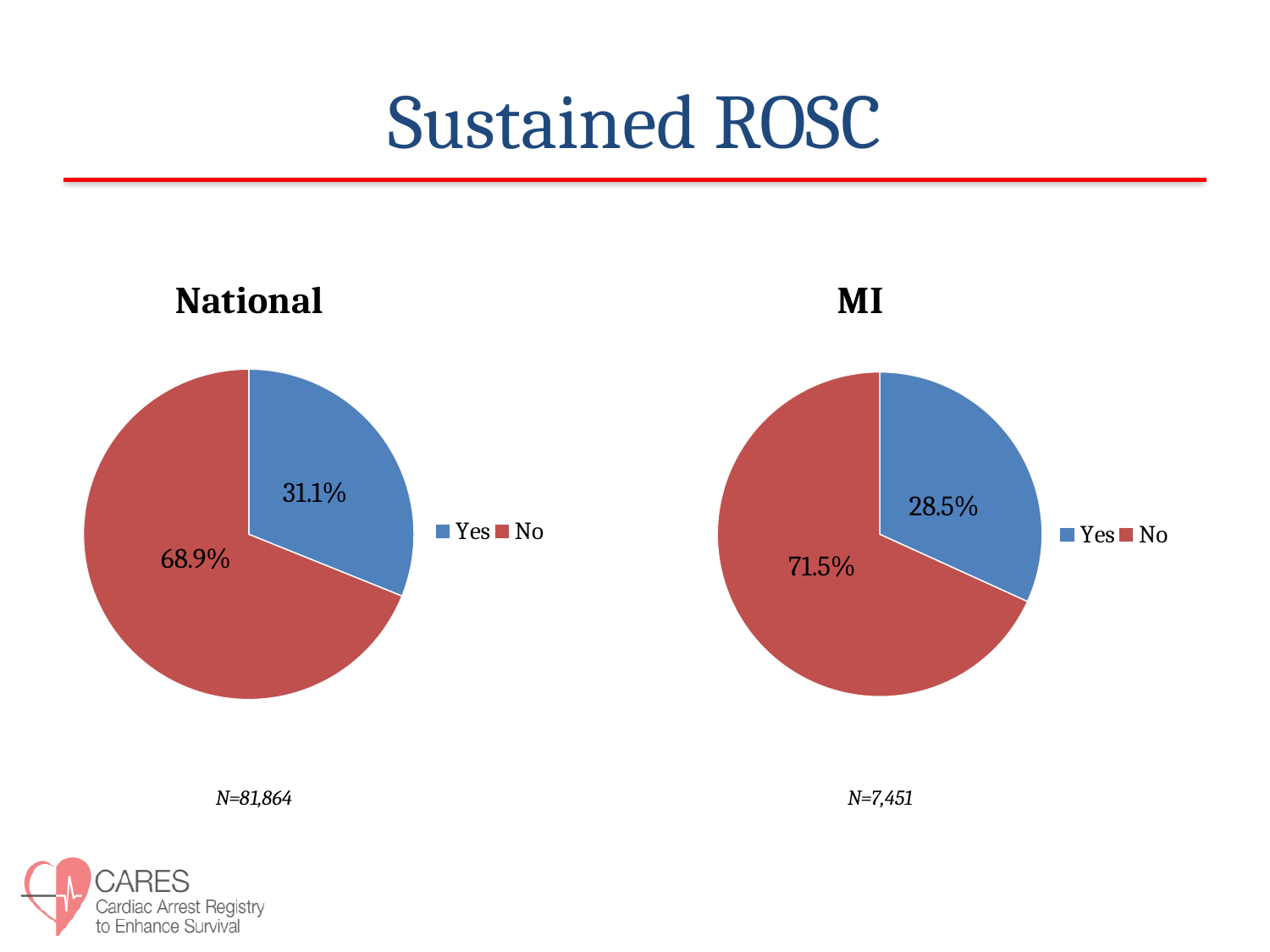
In the National pie chart, what percentage is shown for Yes? 31.1% In the MI pie chart, what percentage is shown for Yes? 28.5% In the National pie chart, what percentage is shown for No? 68.9% In the MI pie chart, which slice is the largest? No In the National pie chart, what is the difference between the No and Yes percentages? 37.8% What type of chart is used for the National data? Pie chart How many slices does the MI pie chart have? 2 How many entries does the legend of the National pie chart list? 2 In the MI pie chart, what colour is the Yes slice? Blue Which chart has the larger Yes share, National or MI? National In the MI pie chart, what percentage is shown for No? 71.5% In the National pie chart, which slice is the smallest? Yes